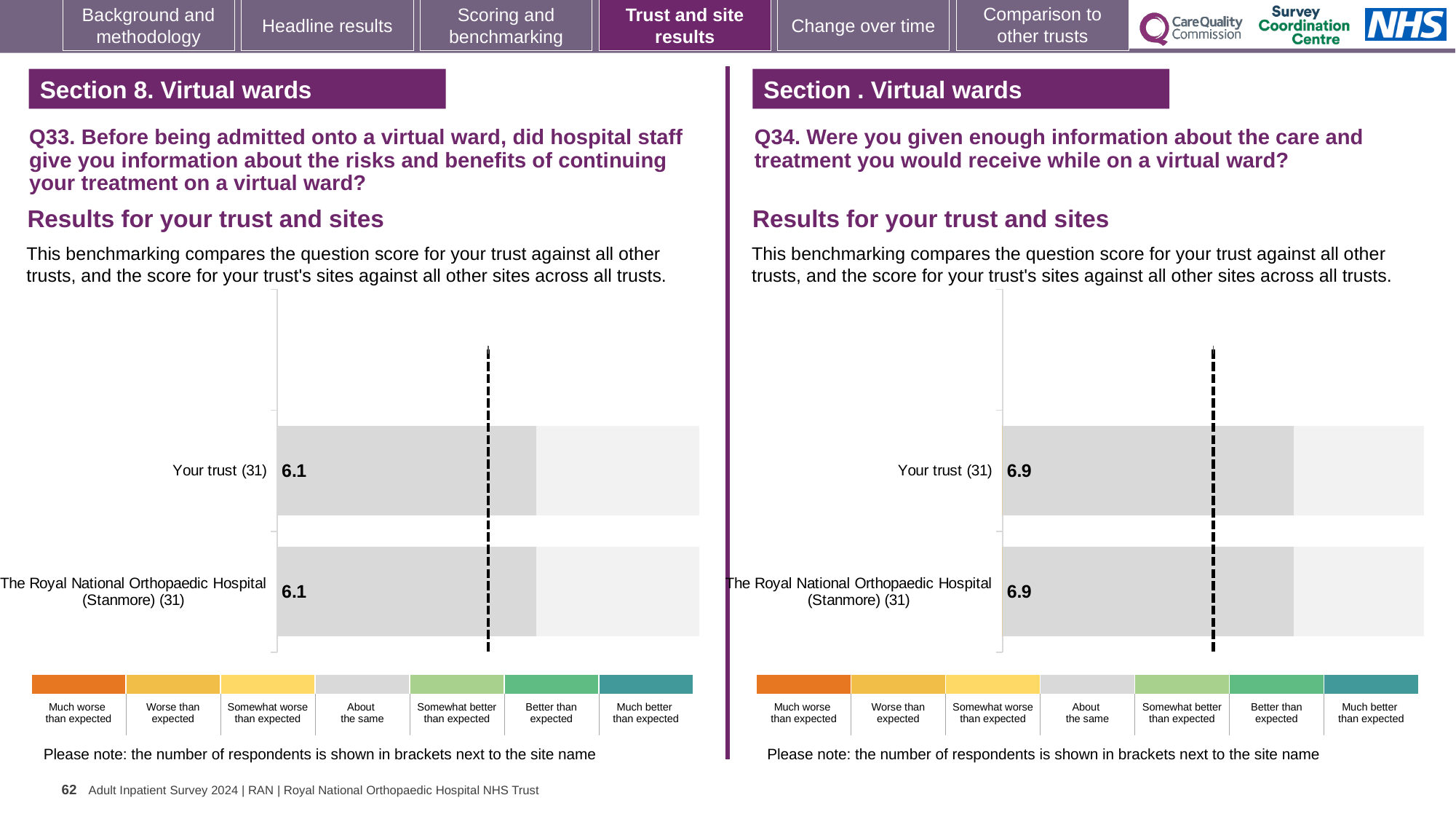
On the Q33 chart (left), what is the score for The Royal National Orthopaedic Hospital (Stanmore)? 6.1 On the Q33 chart (left), what is the score for Your trust? 6.1 How many respondents are shown in brackets for Your trust on the Q34 chart (right)? 31 On the Q34 chart (right), what is the difference between the score for Your trust and the score for The Royal National Orthopaedic Hospital (Stanmore)? 0 How many bars are plotted on the Q34 chart (right)? 2 On the Q34 chart (right), what is the score for Your trust? 6.9 What kind of chart is the Q33 chart (left)? Bar chart Which is larger: the Your trust score on the Q33 chart (left) or the Your trust score on the Q34 chart (right)? Q34 chart (right) On the Q34 chart (right), what is the score for The Royal National Orthopaedic Hospital (Stanmore)? 6.9 How many bars are plotted on the Q33 chart (left)? 2 How many categories does the colour key below the Q33 chart (left) list? 7 On the Q33 chart (left), what is the difference between the score for Your trust and the score for The Royal National Orthopaedic Hospital (Stanmore)? 0